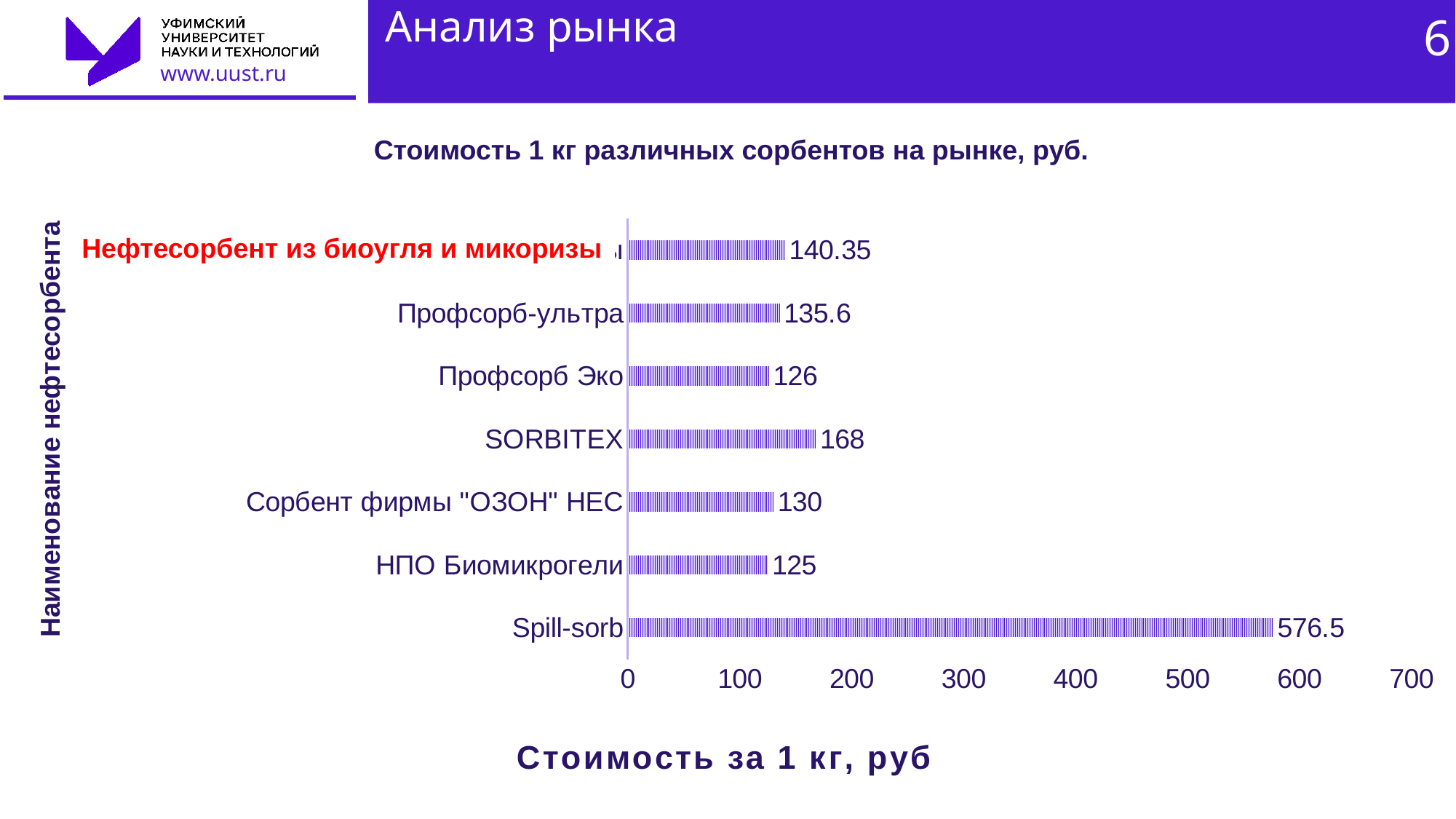
What is the title of the chart? Стоимость 1 кг различных сорбентов на рынке, руб. What is the value for Нефтесорбент из биоугля и микоризы? 140.35 What is the value for Spill-sorb? 576.5 What is the value for SORBITEX? 168 What is the value for Профсорб-ультра? 135.6 Which sorbent has the highest price per kg? Spill-sorb How many sorbents are shown in the chart? 7 Which sorbent has the lowest price per kg? НПО Биомикрогели What kind of chart is shown on the slide? bar chart What is the difference between the values for Сорбент фирмы "ОЗОН" НЕС and НПО Биомикрогели? 5 What is the difference between the values for Spill-sorb and SORBITEX? 408.5 Which is larger, the value for SORBITEX or the value for Профсорб Эко? SORBITEX